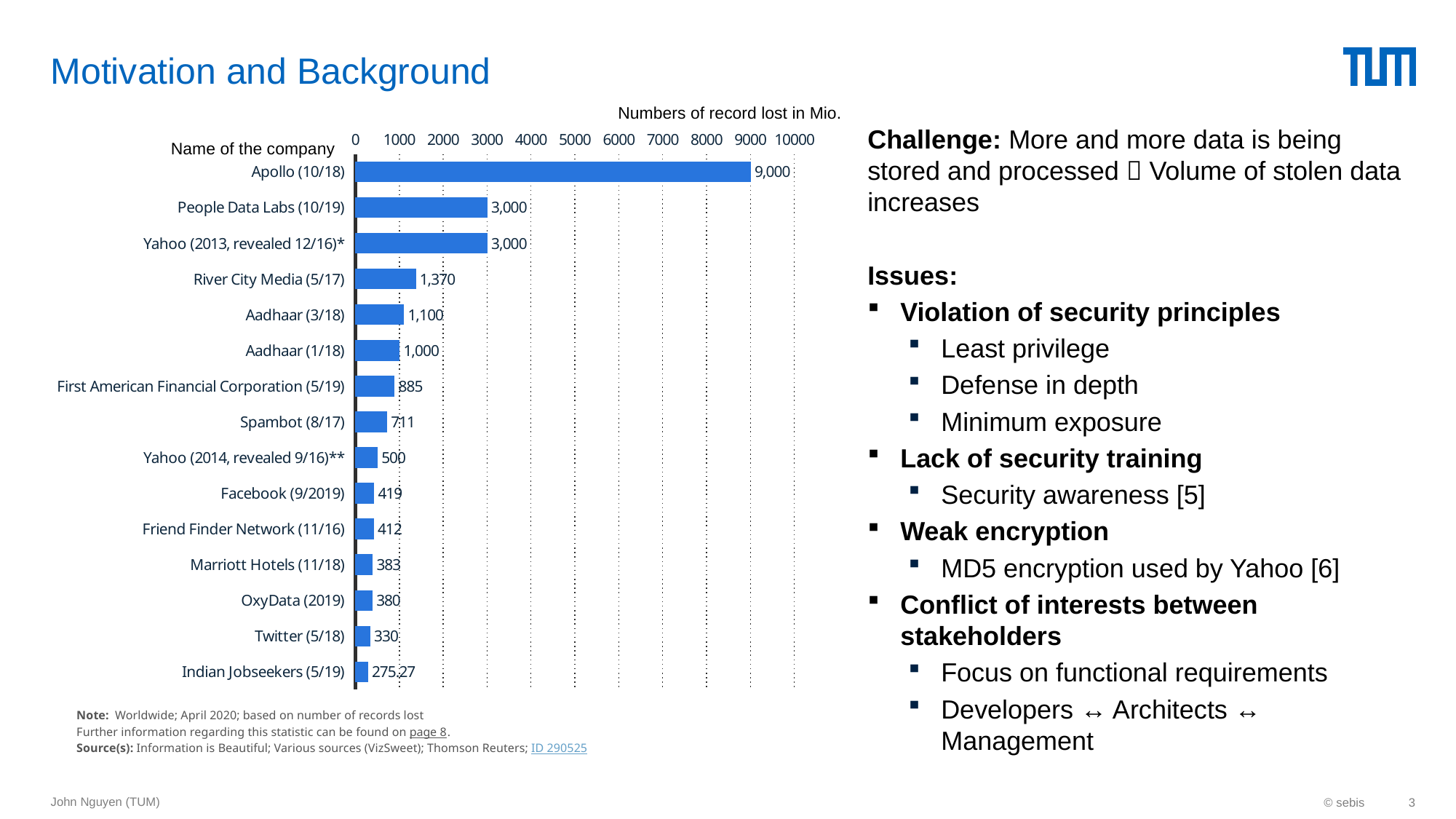
How many companies are listed in the chart? 15 What is the number of records lost for River City Media (5/17)? 1,370 What is the difference in records lost between Apollo (10/18) and People Data Labs (10/19)? 6,000 Is the value for Twitter (5/18) greater or less than 1000? less What is the number of records lost for First American Financial Corporation (5/19)? 885 What is the difference in records lost between Aadhaar (3/18) and Aadhaar (1/18)? 100 What is the number of records lost for Apollo (10/18)? 9,000 What is the number of records lost for Indian Jobseekers (5/19)? 275.27 Which company has the highest number of records lost? Apollo (10/18) Which company has the lowest number of records lost? Indian Jobseekers (5/19) Which has more records lost, Spambot (8/17) or Yahoo (2014, revealed 9/16)**? Spambot (8/17) What type of chart is shown on the slide? Bar chart